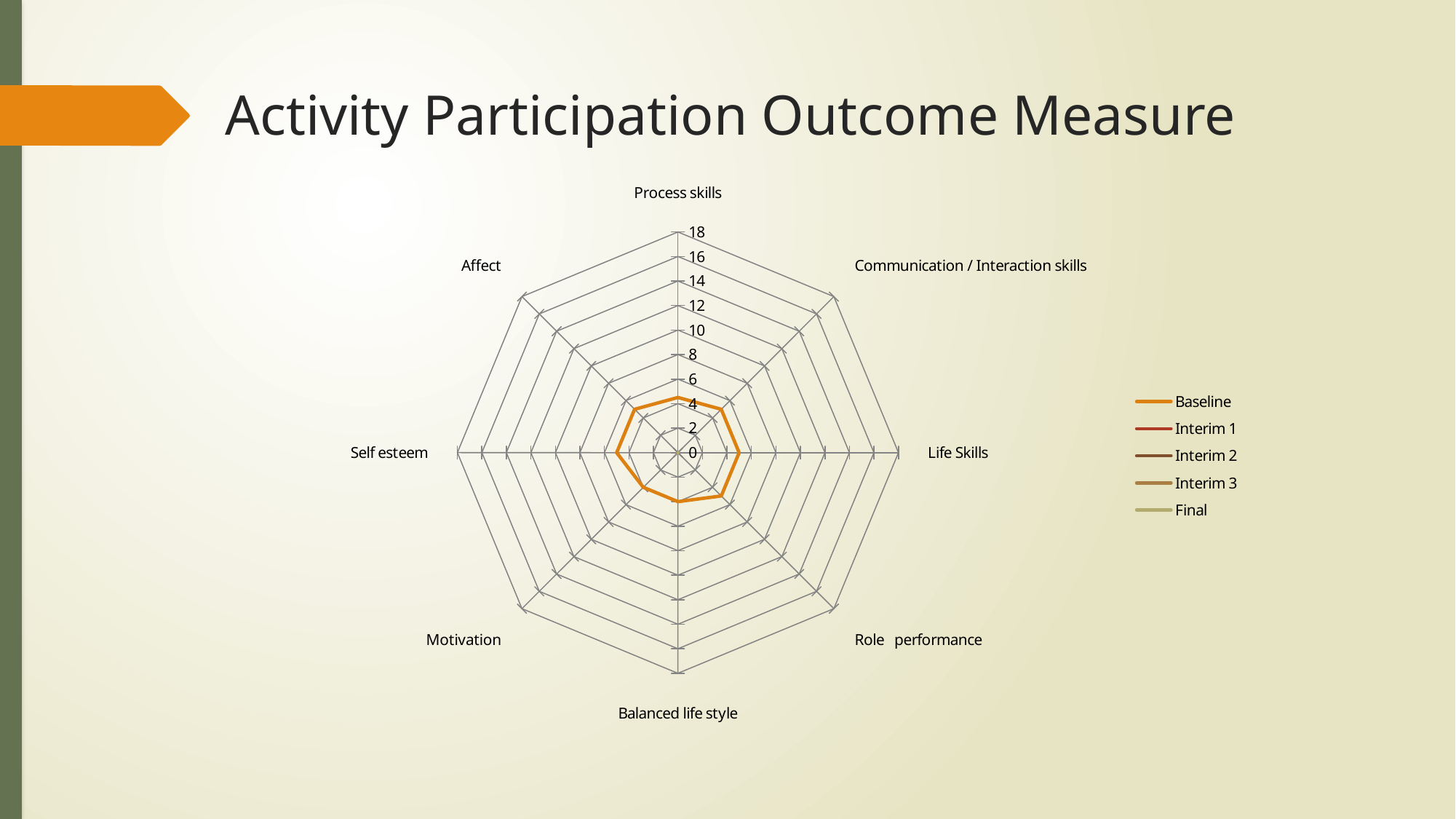
Which series is drawn in orange on the chart? Baseline What is the maximum value shown on the radar chart's axis scale? 18 How many series does the legend list? 5 Is the Baseline value for Balanced life style greater or less than 10? less How many categories (axes) does the radar chart have? 8 What kind of chart is shown on the slide? radar chart Is the Baseline value for Process skills greater or less than 6? less Is the Baseline value for Motivation greater or less than 2? greater What is the title of the slide containing the chart? Activity Participation Outcome Measure